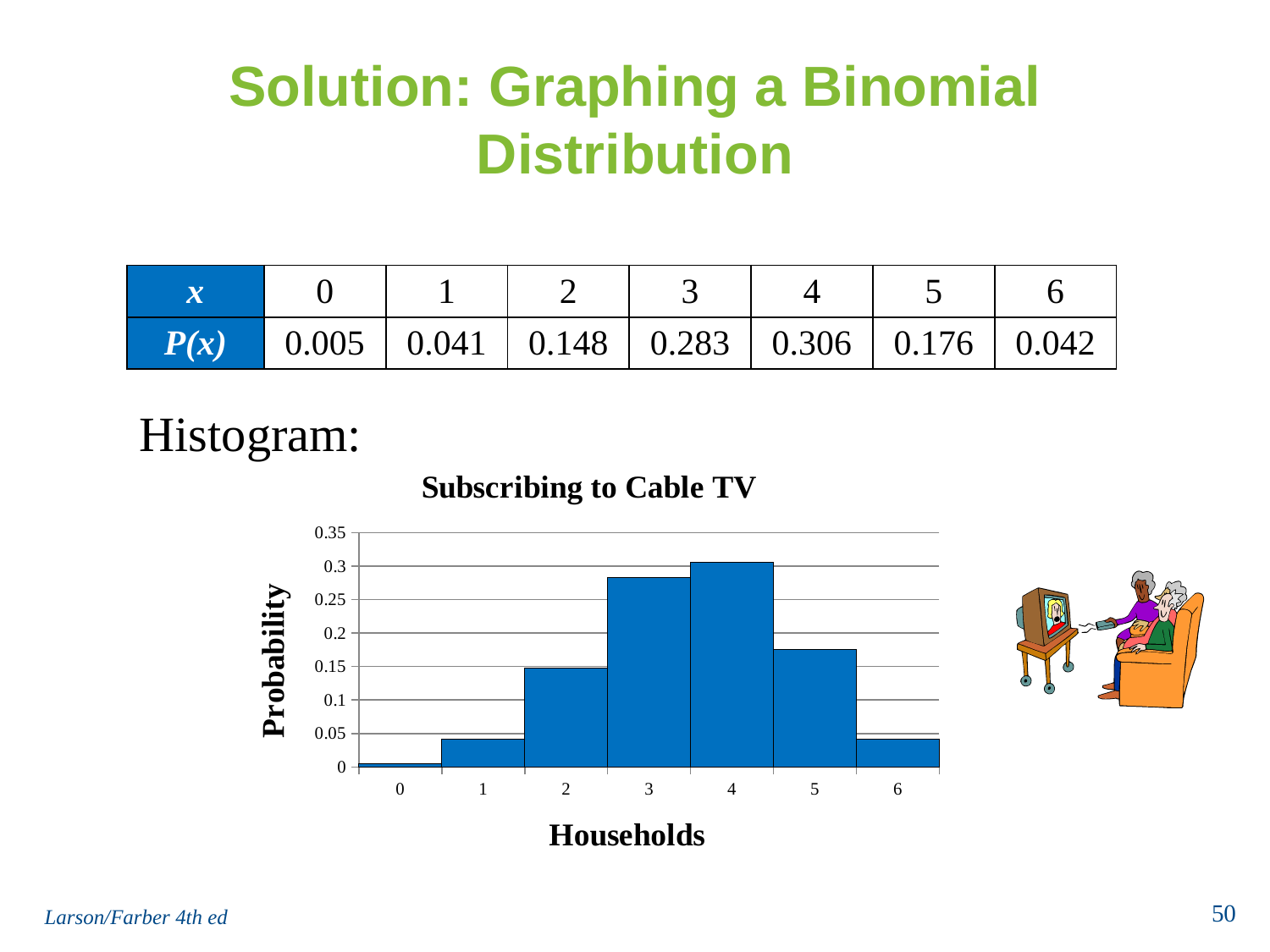
What type of chart is shown on the slide? bar chart What is the difference between the probabilities for 4 households and 3 households? 0.023 Is the probability for 6 households greater or less than 0.05? less What is the title of the chart? Subscribing to Cable TV What is the probability for 4 households? 0.306 Which number of households has the lowest probability in the chart? 0 Which has a larger probability: 5 households or 2 households? 5 households What is the probability for 2 households? 0.148 Is the probability for 3 households greater or less than 0.25? greater What is the label on the y axis of the chart? Probability How many categories (households values) are plotted on the x axis of the chart? 7 Which number of households has the highest probability in the chart? 4